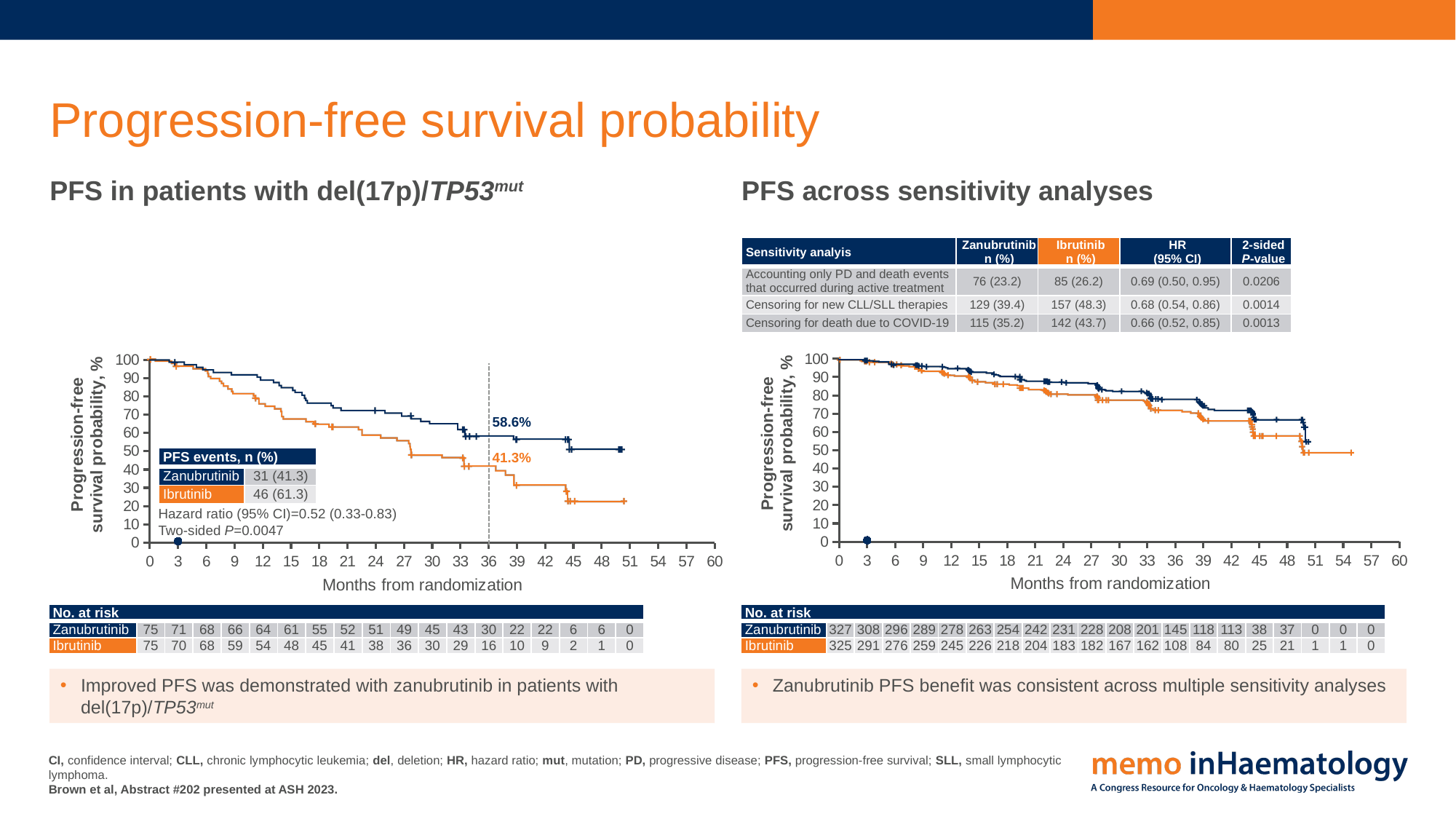
On the left chart (PFS in patients with del(17p)/TP53mut), what is the labelled progression-free survival probability for ibrutinib at 36 months? 41.3% On the left chart (PFS in patients with del(17p)/TP53mut), is the ibrutinib curve at 48 months greater or less than 30? less On the left chart (PFS in patients with del(17p)/TP53mut), how many treatment groups are plotted? 2 On the left chart (PFS in patients with del(17p)/TP53mut), what is the difference in percentage points between the labelled 36-month values for zanubrutinib and ibrutinib? 17.3 On the right chart (PFS across sensitivity analyses), is the ibrutinib curve at 24 months greater or less than 70? greater On the left chart (PFS in patients with del(17p)/TP53mut), how many patients were at risk in the zanubrutinib group at 0 months? 75 On the left chart (PFS in patients with del(17p)/TP53mut), what is the labelled progression-free survival probability for zanubrutinib at 36 months? 58.6% On the left chart (PFS in patients with del(17p)/TP53mut), which treatment has the higher labelled value at 36 months? Zanubrutinib What kind of chart is the right chart (PFS across sensitivity analyses)? Line chart (Kaplan-Meier survival curve) On the right chart (PFS across sensitivity analyses), how many patients were at risk in the ibrutinib group at 0 months? 325 On the right chart (PFS across sensitivity analyses), do the curves rise or fall as months from randomization increase? Fall On the left chart (PFS in patients with del(17p)/TP53mut), is the zanubrutinib curve at 48 months greater or less than 40? greater